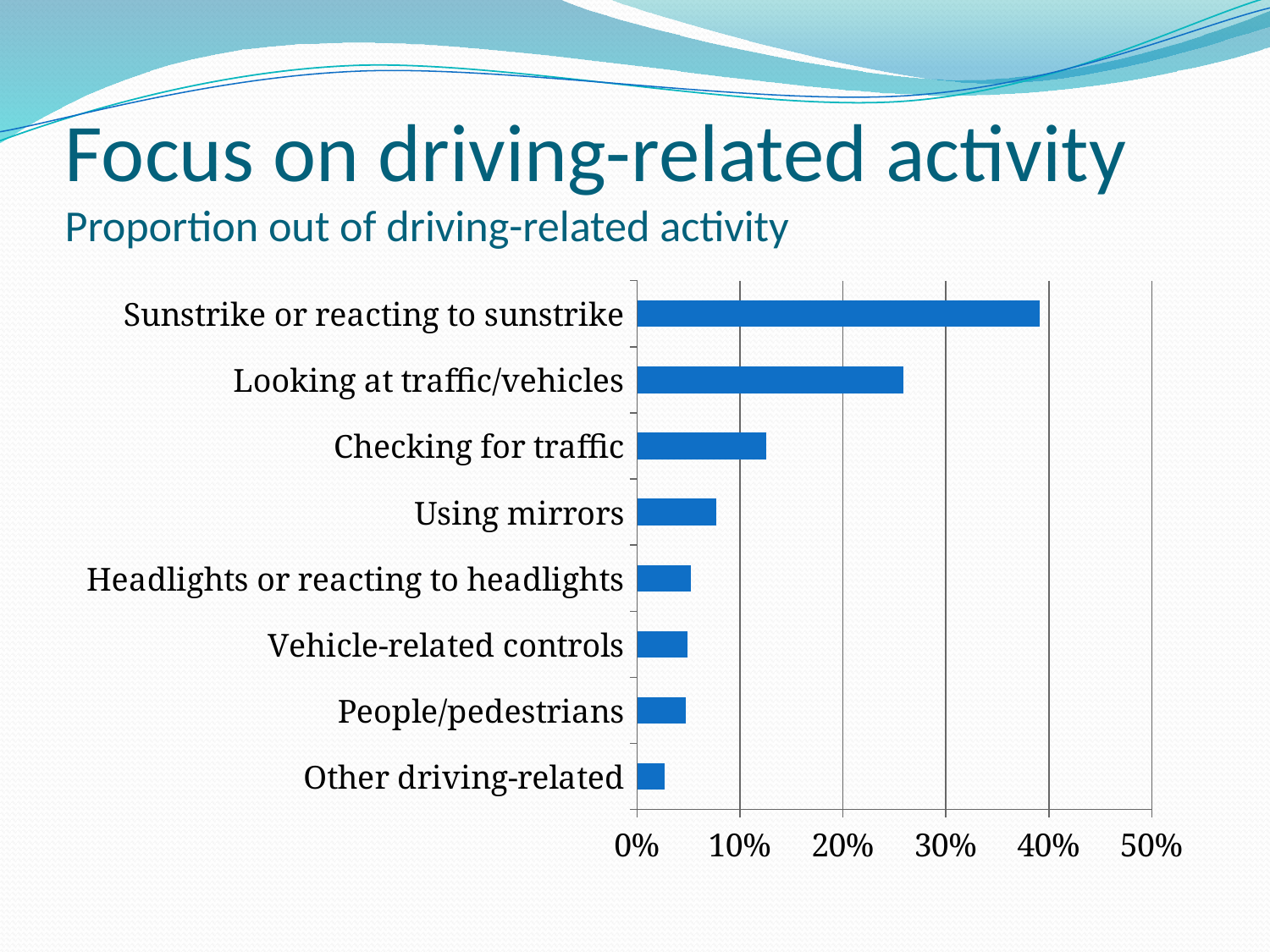
What kind of chart is shown on the slide? bar chart Is the value for Checking for traffic greater or less than 10%? greater Which is larger, the value for Using mirrors or the value for Other driving-related? Using mirrors Which category has the lowest value? Other driving-related Is the value for Sunstrike or reacting to sunstrike greater or less than 30%? greater How many categories are plotted in the chart? 8 Is the value for Looking at traffic/vehicles greater or less than 20%? greater Which category has the highest value? Sunstrike or reacting to sunstrike What is the subtitle shown above the chart? Proportion out of driving-related activity Which is larger, the value for Looking at traffic/vehicles or the value for Checking for traffic? Looking at traffic/vehicles